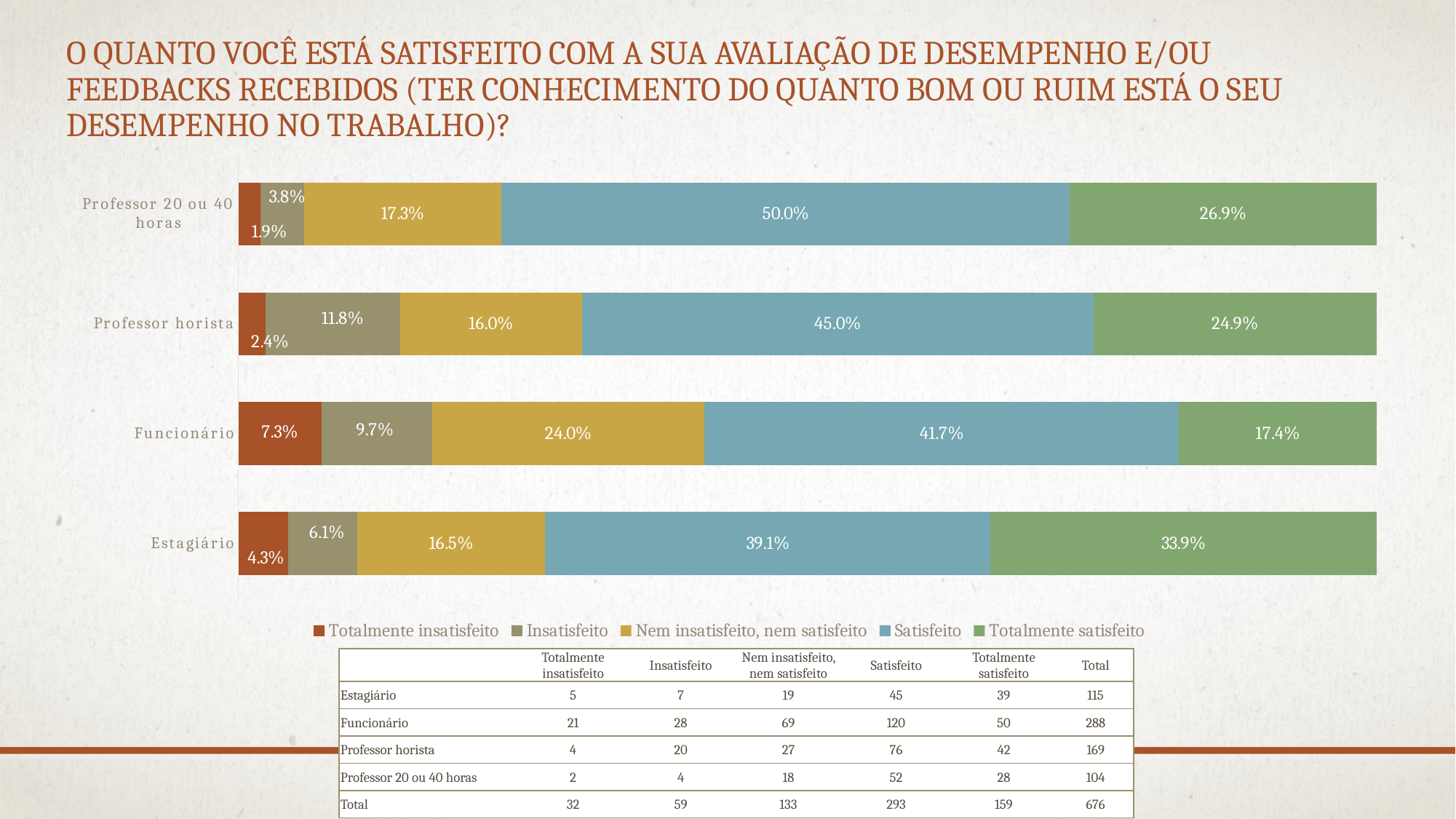
What is the value for Totalmente satisfeito in the Estagiário bar? 33.9% Which is larger: the Totalmente insatisfeito value for Funcionário or for Estagiário? Funcionário Which legend entry is shown in green? Totalmente satisfeito What is the value for Satisfeito in the Professor 20 ou 40 horas bar? 50.0% What is the value for Insatisfeito in the Professor horista bar? 11.8% Which category has the highest value for Satisfeito? Professor 20 ou 40 horas What is the value for Nem insatisfeito, nem satisfeito in the Funcionário bar? 24.0% What is the difference between the Totalmente satisfeito values for Estagiário and Funcionário? 16.5 percentage points How many series does the legend list? 5 Which category has the lowest value for Totalmente insatisfeito? Professor 20 ou 40 horas How many categories (bars) are shown in the chart? 4 What kind of chart is shown on the slide? Stacked bar chart